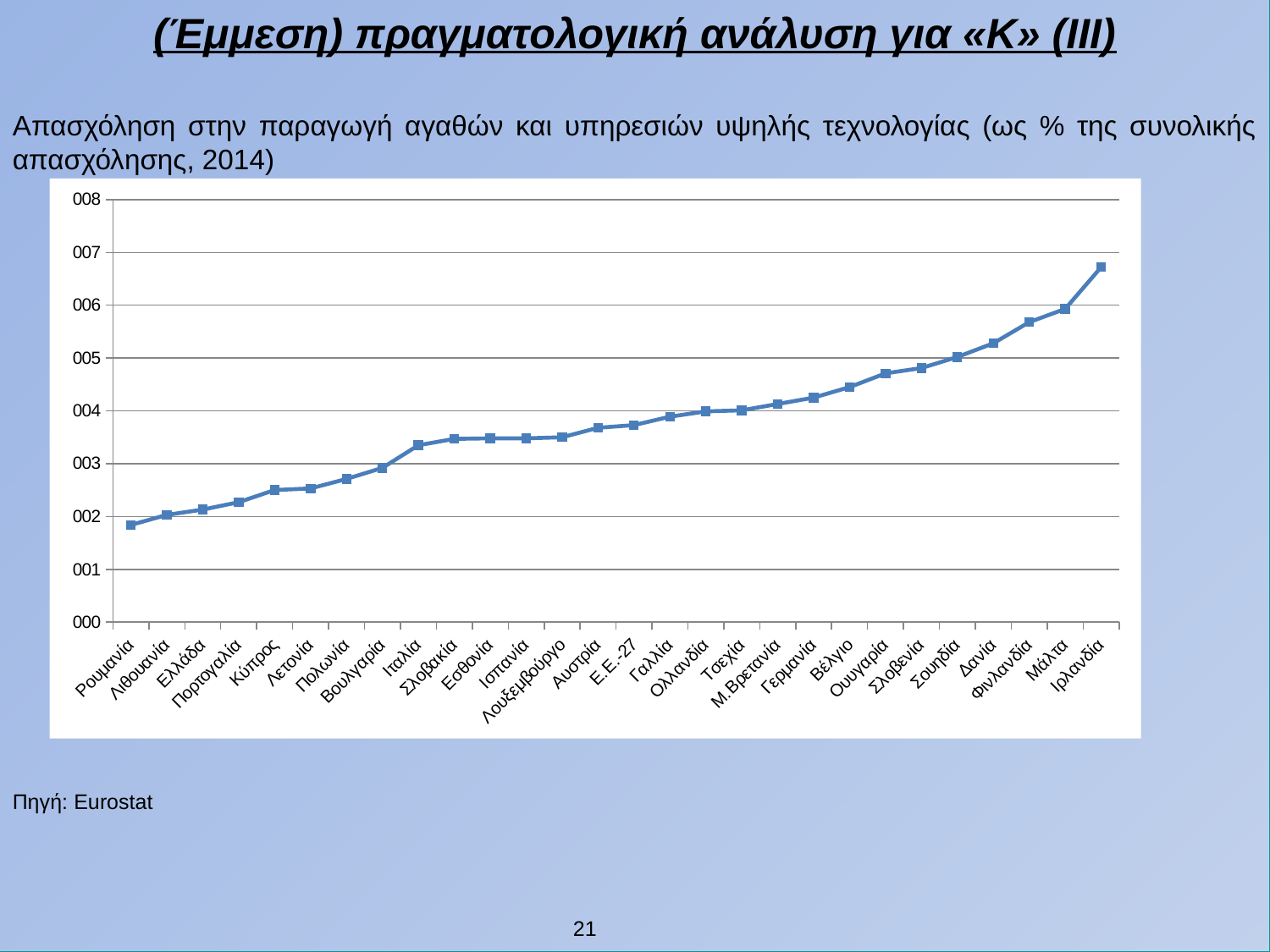
Which has the larger value, Γερμανία or Κύπρος? Γερμανία Which category has the lowest value in the chart? Ρουμανία Is the value for Ιταλία greater or less than 003? greater Which has the larger value, Ελλάδα or Δανία? Δανία What source is cited for the chart data on the slide? Eurostat What kind of chart is shown on the slide? line chart Do the values rise or fall moving from left to right along the x axis? rise How many categories are plotted along the x axis of the chart? 28 Is the value for Ρουμανία greater or less than 002? less Is the value for Ιρλανδία greater or less than 006? greater Which category has the highest value in the chart? Ιρλανδία